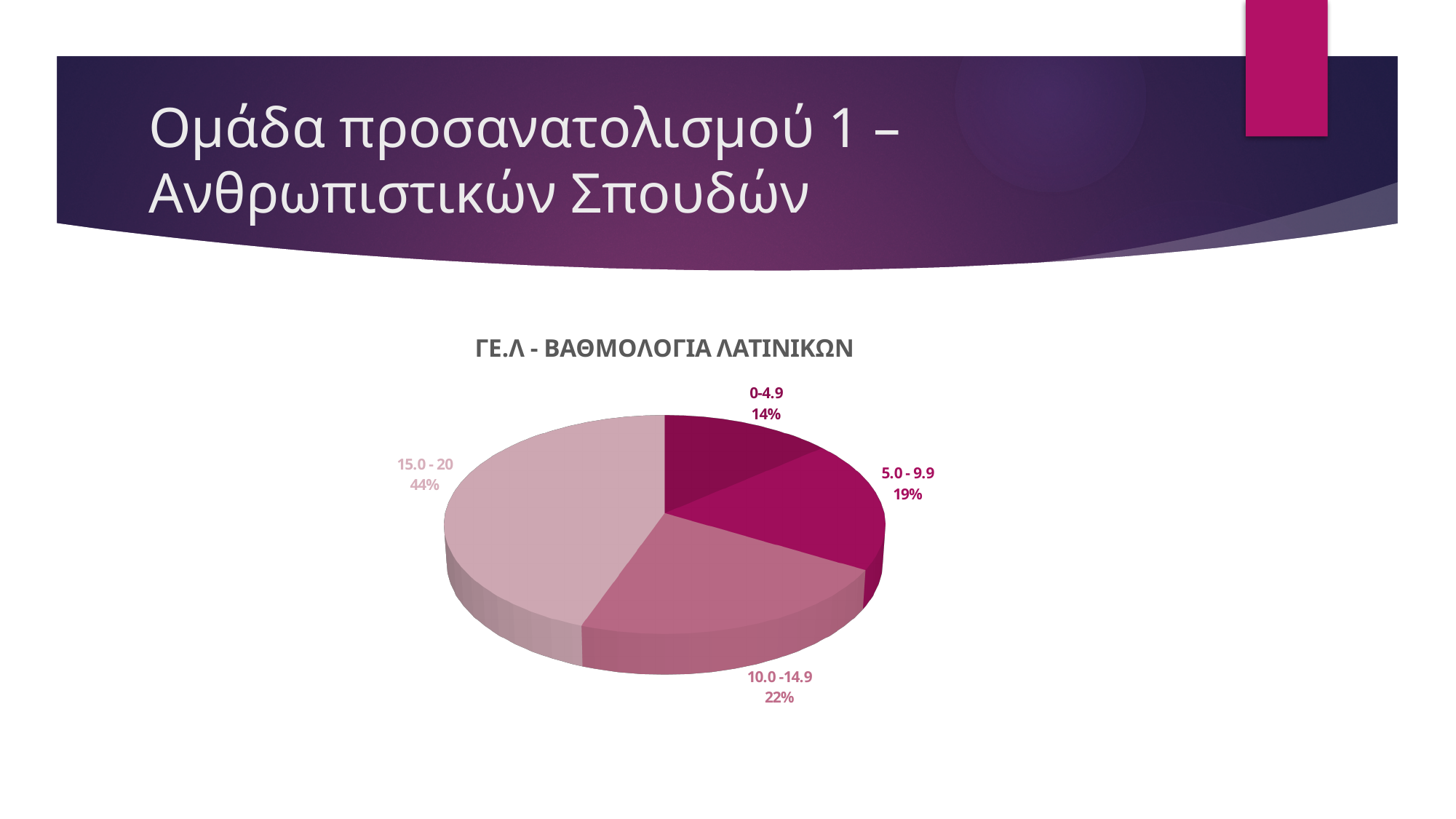
Which category has the smallest share of the pie? 0-4.9 What percentage is shown for the 0-4.9 category? 14% What is the difference in percentage points between the 15.0 - 20 and 10.0 -14.9 categories? 22 What is the combined percentage of the 0-4.9 and 5.0 - 9.9 categories? 33% How many categories (slices) does the pie chart have? 4 What type of chart is shown on the slide? Pie chart What share of the pie does the 15.0 - 20 category have? 44% Which is larger, the share for 5.0 - 9.9 or the share for 0-4.9? 5.0 - 9.9 What percentage is shown for the 5.0 - 9.9 category? 19% Which category has the largest share of the pie? 15.0 - 20 What is the title of the chart? ΓΕ.Λ - ΒΑΘΜΟΛΟΓΙΑ ΛΑΤΙΝΙΚΩΝ What percentage is shown for the 10.0 -14.9 category? 22%